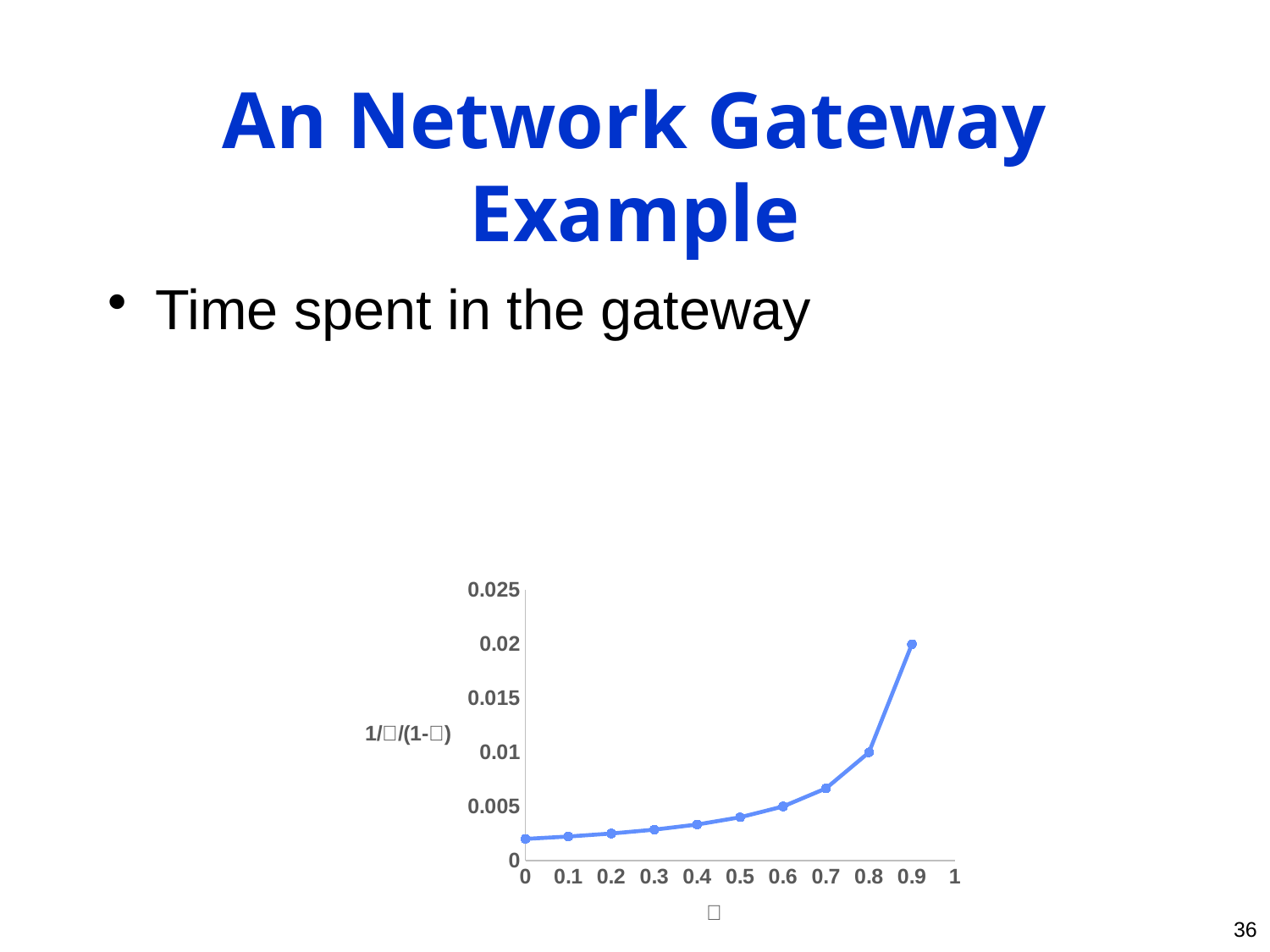
At which x-axis value is the plotted value lowest? 0 What kind of chart is shown on the slide? line chart Is the plotted value at x = 0.5 greater or less than 0.005? less At which x-axis value is the plotted value highest? 0.9 How many data points are plotted on the line? 10 Do the plotted values rise or fall as the x-axis value increases from 0 to 0.9? rise What is the difference between the plotted values at x = 0.9 and x = 0.8? 0.01 What is the plotted value at x = 0.8? 0.01 Which has the larger plotted value, x = 0.8 or x = 0.6? 0.8 What is the plotted value at x = 0.9? 0.02 Is the plotted value at x = 0.7 greater or less than 0.005? greater What is the highest value shown on the y-axis? 0.025